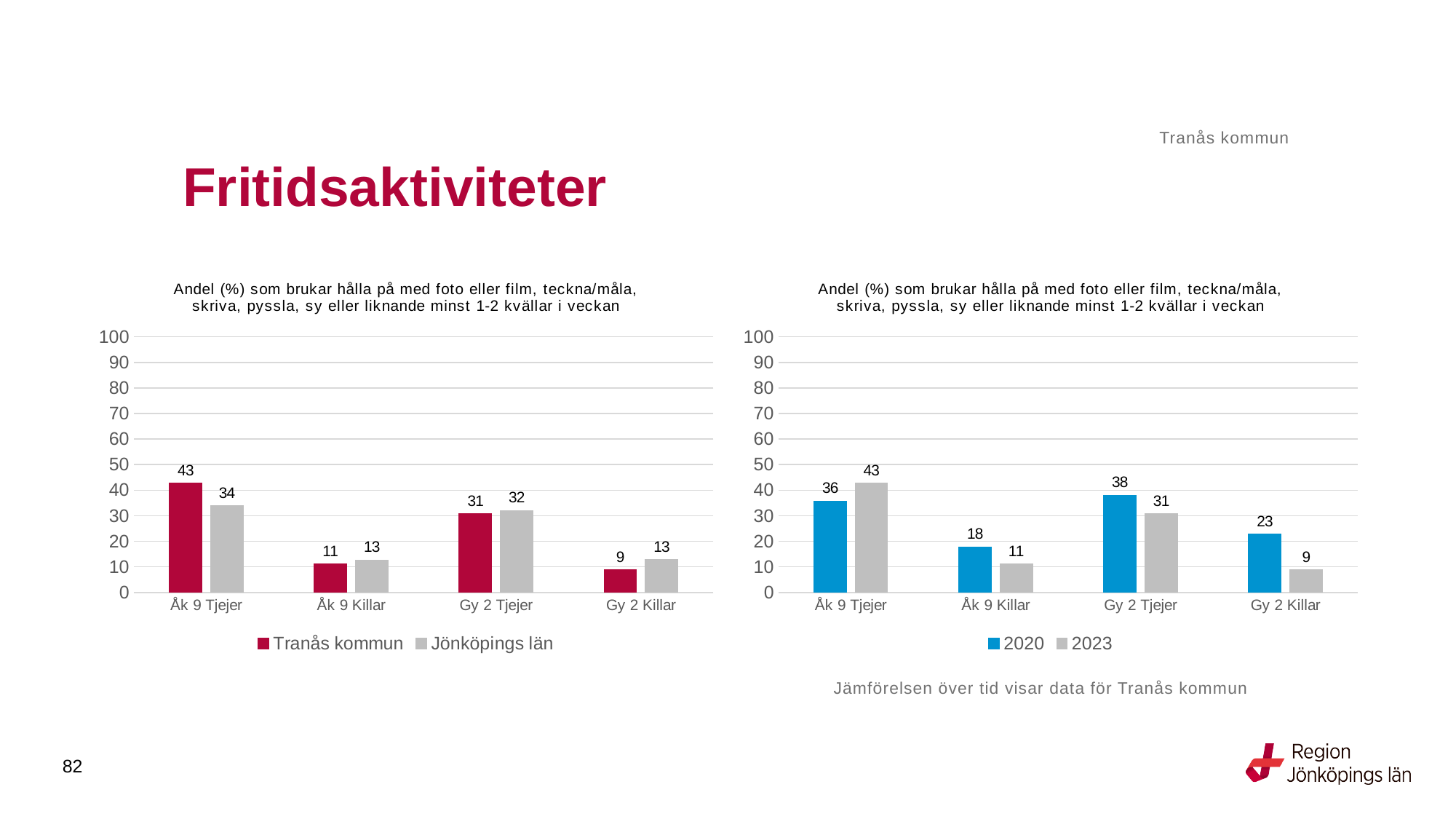
In the right chart (2020 vs 2023), which category has the highest value for 2020? Gy 2 Tjejer What kind of chart is the left chart? Bar chart In the right chart (2020 vs 2023), which is larger for Åk 9 Tjejer: the 2020 value or the 2023 value? 2023 In the left chart (Tranås kommun vs Jönköpings län), which category has the lowest value for Tranås kommun? Gy 2 Killar How many series does the legend of the right chart list? 2 In the right chart (2020 vs 2023), what is the value for 2023 for Åk 9 Killar? 11 In the right chart (2020 vs 2023), what is the difference between the 2020 and 2023 values for Gy 2 Killar? 14 In the right chart (2020 vs 2023), what is the value for 2020 for Gy 2 Tjejer? 38 In the left chart (Tranås kommun vs Jönköpings län), what is the value for Tranås kommun for Åk 9 Tjejer? 43 In the left chart (Tranås kommun vs Jönköpings län), what is the difference between Tranås kommun and Jönköpings län for Åk 9 Tjejer? 9 How many categories are shown on the x axis of the left chart? 4 In the left chart (Tranås kommun vs Jönköpings län), what is the value for Jönköpings län for Gy 2 Killar? 13